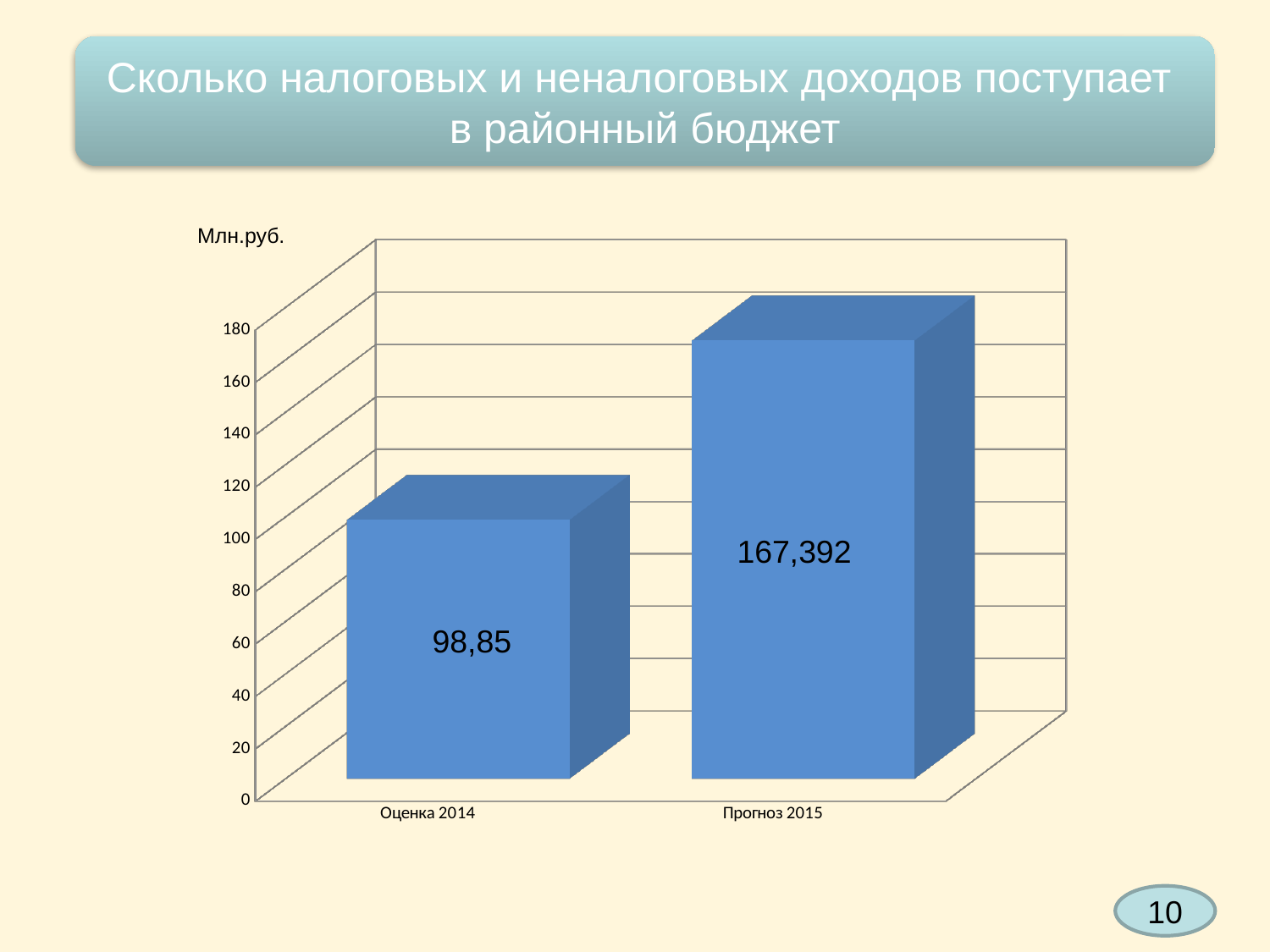
What is the difference between the values for Прогноз 2015 and Оценка 2014? 68,542 What unit is shown above the vertical axis of the chart? Млн.руб. What is the value for Оценка 2014? 98,85 What kind of chart is shown on the slide? bar chart Which category has the highest value? Прогноз 2015 Which is larger, the value for Оценка 2014 or the value for Прогноз 2015? Прогноз 2015 Is the value for Прогноз 2015 greater or less than 160? greater Do the values rise or fall from Оценка 2014 to Прогноз 2015? rise How many categories are shown on the x axis? 2 Which category has the lowest value? Оценка 2014 What is the value for Прогноз 2015? 167,392 Is the value for Оценка 2014 greater or less than 100? less